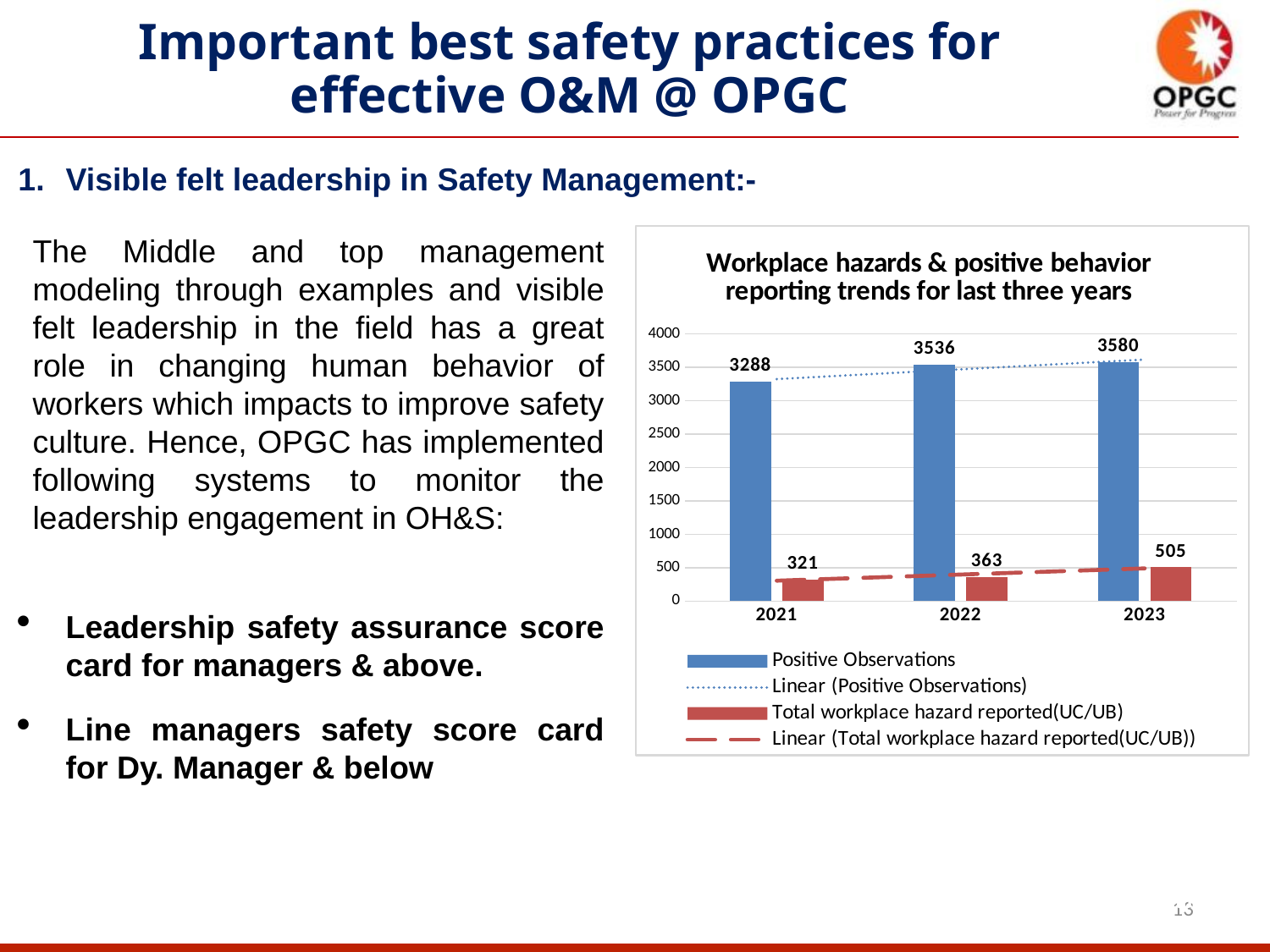
Which is larger: Total workplace hazard reported(UC/UB) in 2022 or in 2021? 2022 What kind of chart is shown on the slide? Bar chart What is the value of Positive Observations for 2022? 3536 How many years are shown on the x axis of the chart? 3 Which year has the highest value for Positive Observations? 2023 Do the Positive Observations values rise or fall from 2021 to 2023? Rise Which year has the lowest value for Total workplace hazard reported(UC/UB)? 2021 What is the value of Positive Observations for 2021? 3288 How many entries does the chart legend list? 4 What is the value of Total workplace hazard reported(UC/UB) for 2023? 505 What is the difference between Positive Observations in 2022 and 2021? 248 What is the difference between Total workplace hazard reported(UC/UB) in 2023 and 2022? 142